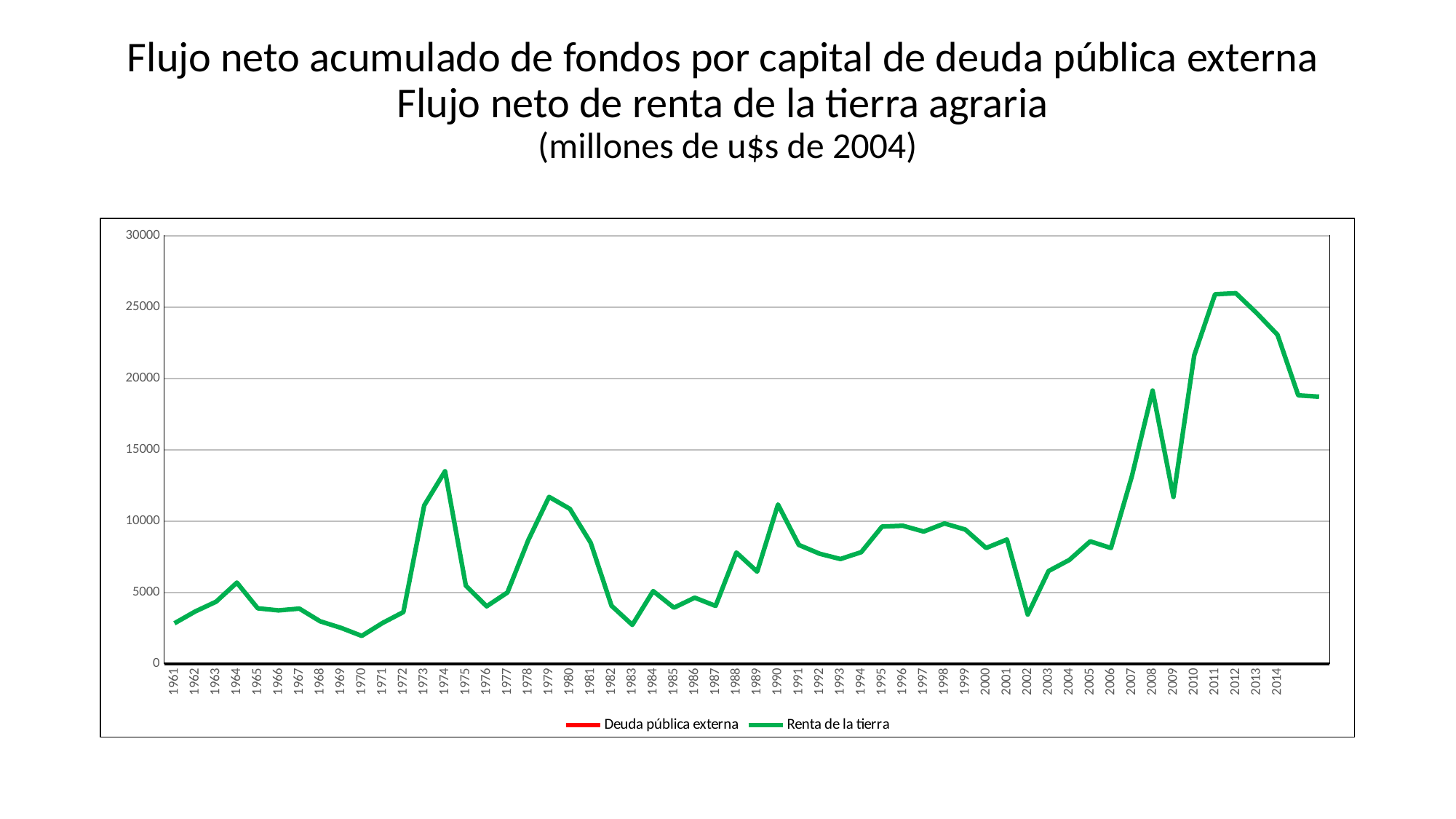
Which year has the higher value of Renta de la tierra, 1974 or 1979? 1974 Does the Renta de la tierra line rise or fall from 2012 to 2014? fall Is the value of Renta de la tierra for 2008 greater or less than 15000? greater What kind of chart is shown on the slide? line chart What unit is stated in the chart title? millones de u$s de 2004 Is the value of Renta de la tierra for 2002 greater or less than 5000? less Is the value of Renta de la tierra for 1961 greater or less than 5000? less Which year has the higher value of Renta de la tierra, 2008 or 2009? 2008 How many series does the legend list? 2 Which series is drawn in green in the legend? Renta de la tierra